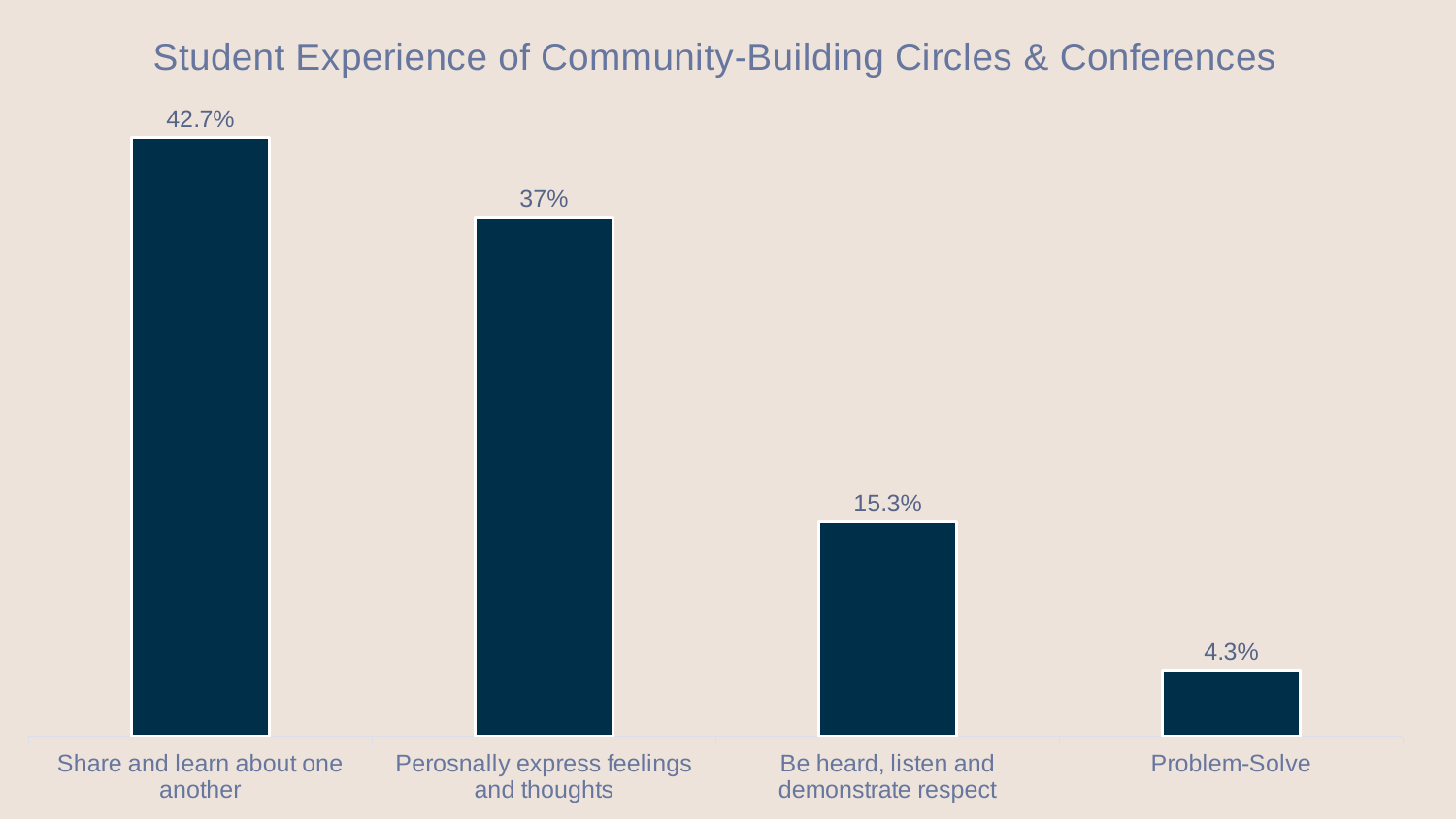
How many categories are shown in the chart? 4 Which is larger, the value for "Perosnally express feelings and thoughts" or the value for "Be heard, listen and demonstrate respect"? Perosnally express feelings and thoughts Which category has the lowest value? Problem-Solve What is the difference between the values for "Share and learn about one another" and "Perosnally express feelings and thoughts"? 5.7% Which category has the highest value? Share and learn about one another What is the difference between the values for "Be heard, listen and demonstrate respect" and "Problem-Solve"? 11% What kind of chart is shown on the slide? Bar chart What is the value for "Share and learn about one another"? 42.7% What is the value for "Problem-Solve"? 4.3% What is the value for "Be heard, listen and demonstrate respect"? 15.3% What is the title of the chart? Student Experience of Community-Building Circles & Conferences What is the value for "Perosnally express feelings and thoughts"? 37%